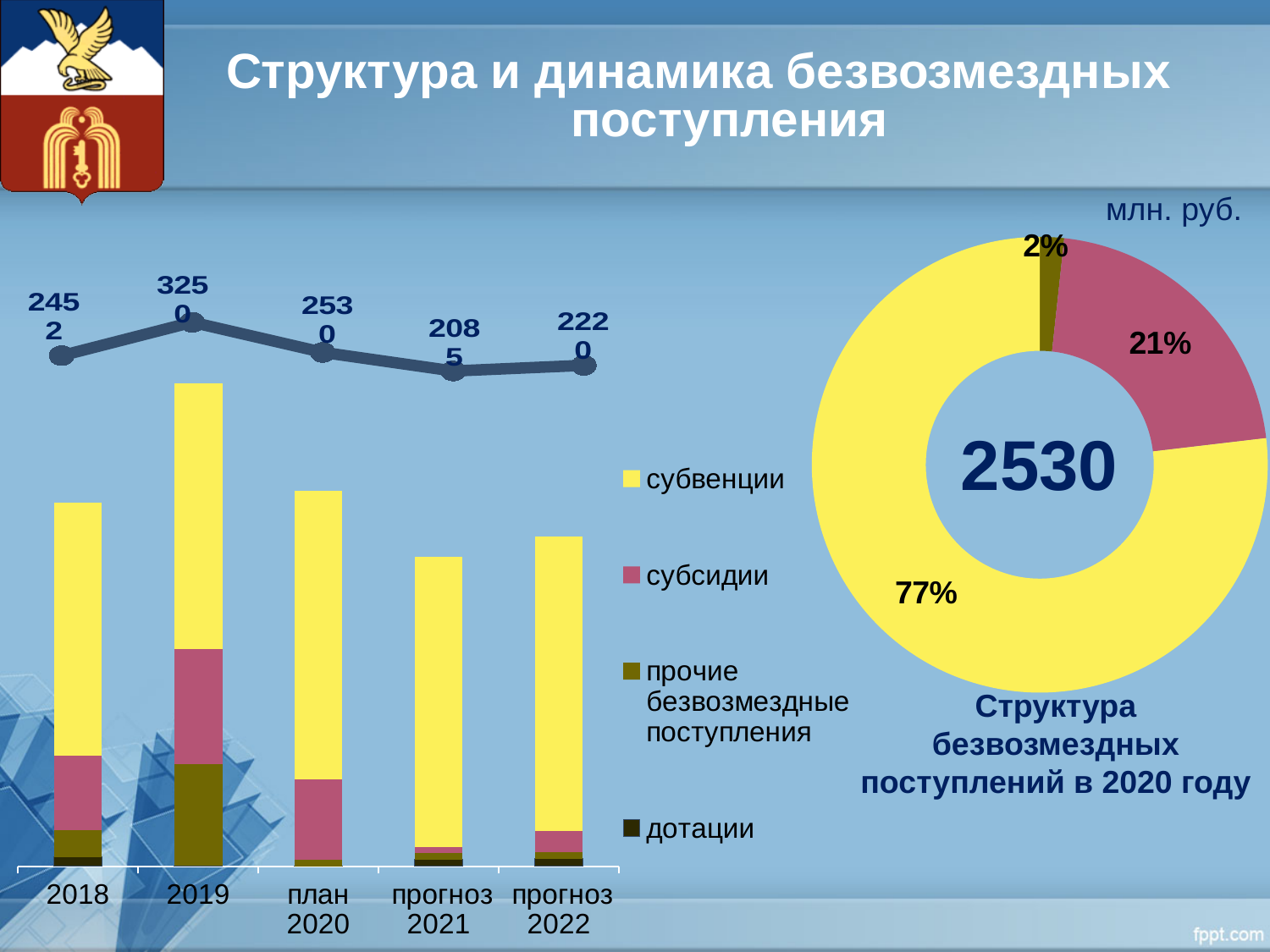
In the stacked bar chart on the left, what value does the line show for прогноз 2021? 2085 In the stacked bar chart on the left, which category has the lowest total? прогноз 2021 In the stacked bar chart on the left, what value does the line show for 2019? 3250 In the doughnut chart on the right, what share do прочие безвозмездные поступления have? 2% In the doughnut chart 'Структура безвозмездных поступлений в 2020 году', what share do субвенции have? 77% In the stacked bar chart on the left, which is larger: the value for 2018 or for прогноз 2022? 2018 In the stacked bar chart on the left, which category has the highest total? 2019 How many series does the legend of the stacked bar chart on the left list? 4 In the stacked bar chart on the left, what is the difference between the line values for 2019 and план 2020? 720 How many categories are shown on the x axis of the stacked bar chart on the left? 5 What total value is printed in the centre of the doughnut chart on the right? 2530 In the doughnut chart 'Структура безвозмездных поступлений в 2020 году', what share do субсидии have? 21%